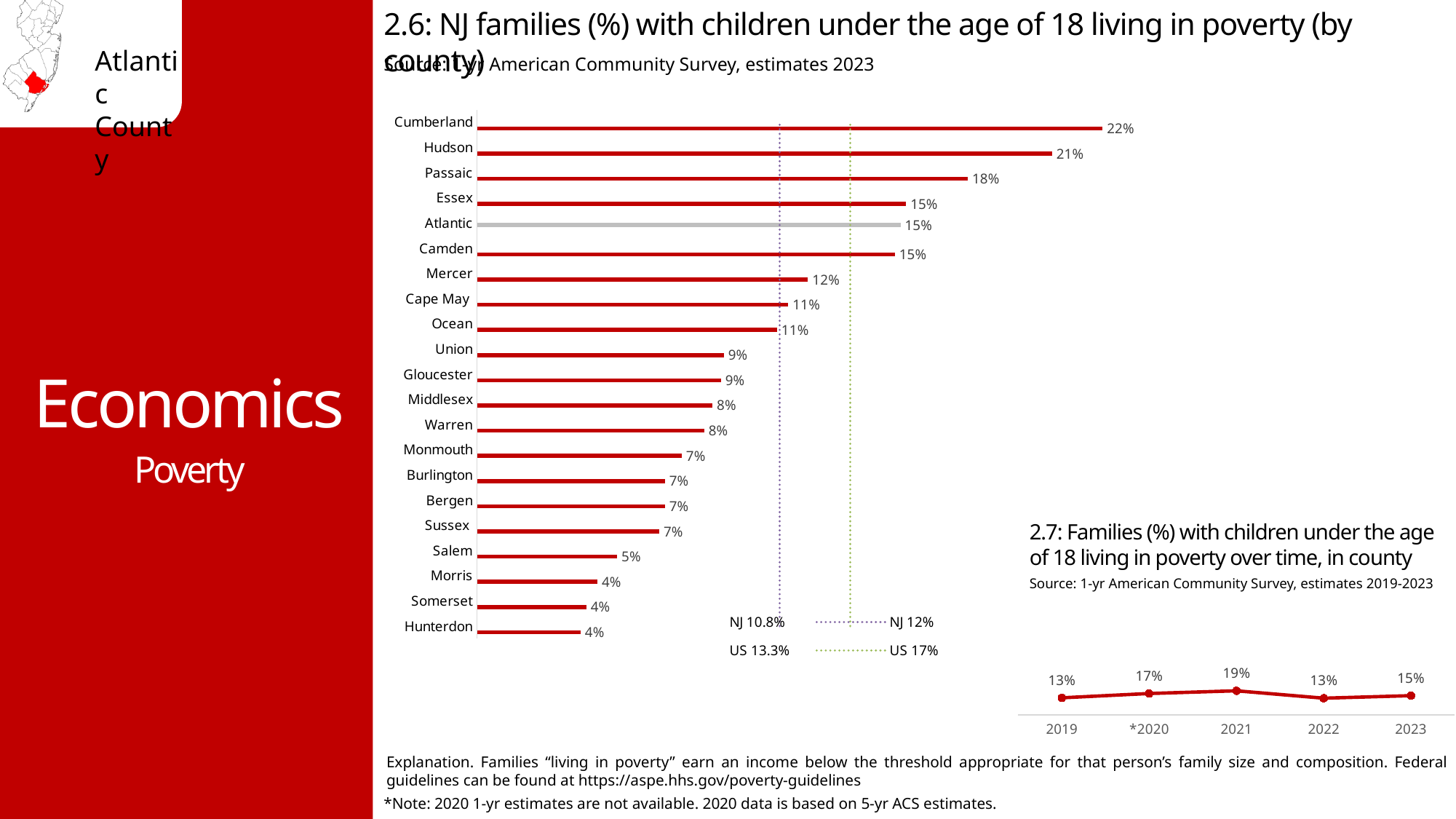
In chart 2.7 (families in poverty over time, in county), what is the value for 2021? 19% In chart 2.6 (by county), which county has the highest value? Cumberland In chart 2.7 (over time, in county), what is the difference between 2021 and 2022? 6% In chart 2.6 (NJ families with children under 18 living in poverty by county), what is the value for Cumberland? 22% In chart 2.6 (by county), what is the value for Atlantic? 15% In chart 2.6 (by county), how many counties are plotted? 21 In chart 2.7 (over time, in county), which year has the highest value? 2021 In chart 2.6 (by county), which is larger, Mercer or Union? Mercer What kind of chart is chart 2.6 (by county)? Bar chart What kind of chart is chart 2.7 (over time, in county)? Line chart In chart 2.6 (by county), what is the difference between Hudson and Passaic? 3%